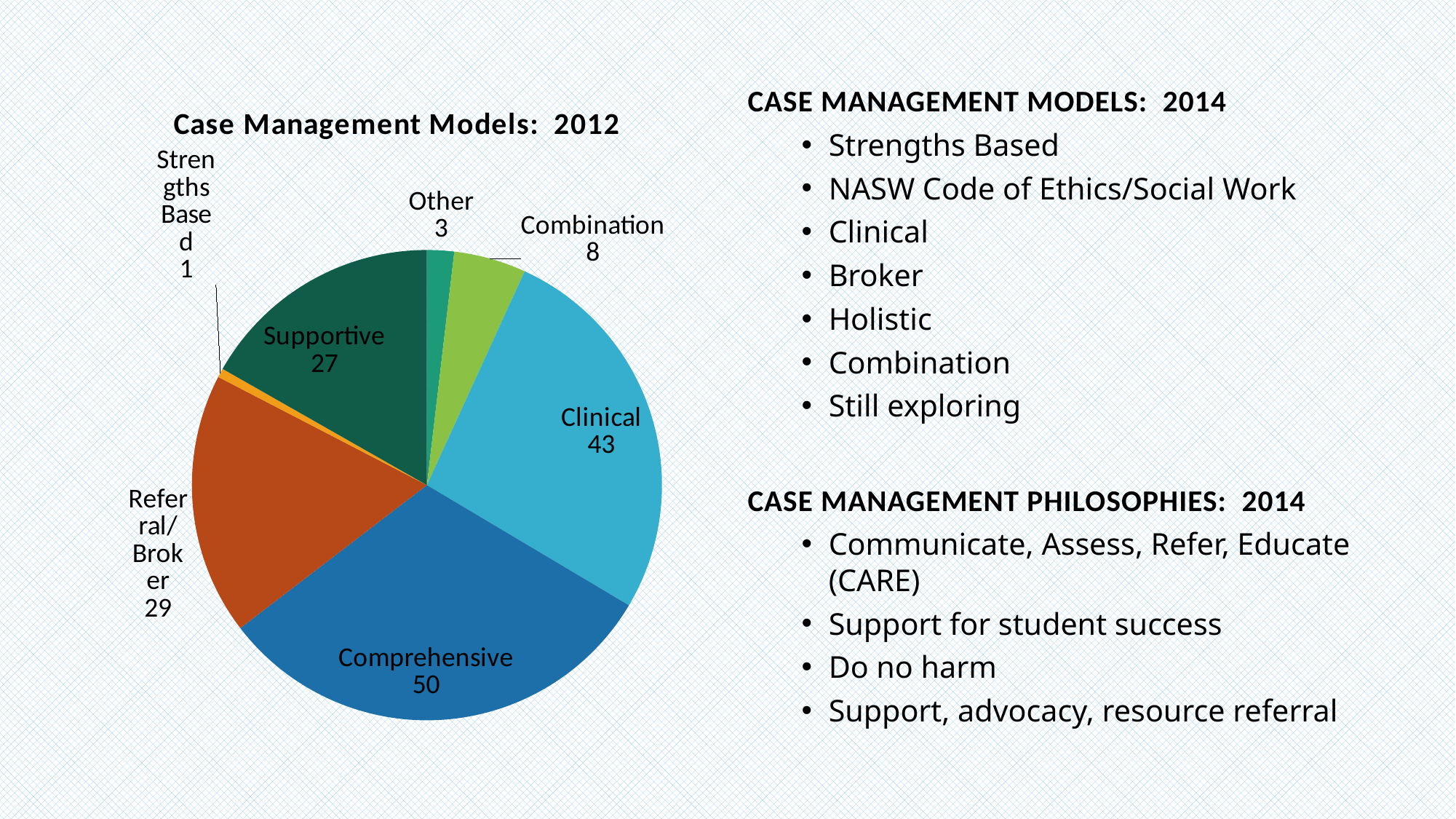
What is the value for Combination? 8 Which is larger, Supportive or Referral/Broker? Referral/Broker What is the total of all the slices in the pie chart? 161 What is the value for Other? 3 How many slices does the pie chart have? 7 What is the value for Clinical? 43 What is the difference between the values for Comprehensive and Clinical? 7 What type of chart is shown on the slide? Pie chart What is the title of the chart? Case Management Models: 2012 Which category has the smallest slice? Strengths Based What is the value for Referral/Broker? 29 Which category has the largest slice? Comprehensive